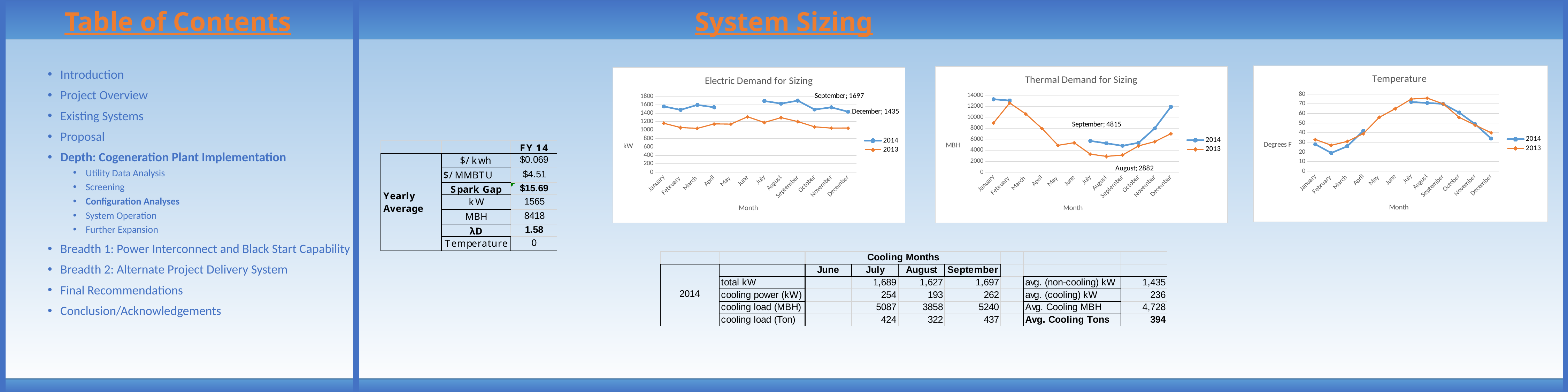
What kind of chart is the "Electric Demand for Sizing" chart? line chart How many series does the legend of the "Thermal Demand for Sizing" chart list? 2 In the "Thermal Demand for Sizing" chart, what is the labeled value for August? 2882 In the "Temperature" chart, is the 2014 value for February greater or less than 30? less In the "Thermal Demand for Sizing" chart, what is the labeled value for September? 4815 In the "Electric Demand for Sizing" chart, what is the labeled value for December? 1435 In the "Thermal Demand for Sizing" chart, is the 2014 value for January greater or less than 12000? greater What is the y-axis label of the "Thermal Demand for Sizing" chart? MBH How many months are shown on the x axis of the "Temperature" chart? 12 In the "Electric Demand for Sizing" chart, which series has the higher value in January, 2014 or 2013? 2014 In the "Electric Demand for Sizing" chart, what is the labeled value for September? 1697 In the "Temperature" chart, do the 2014 values rise or fall from February to July? rise